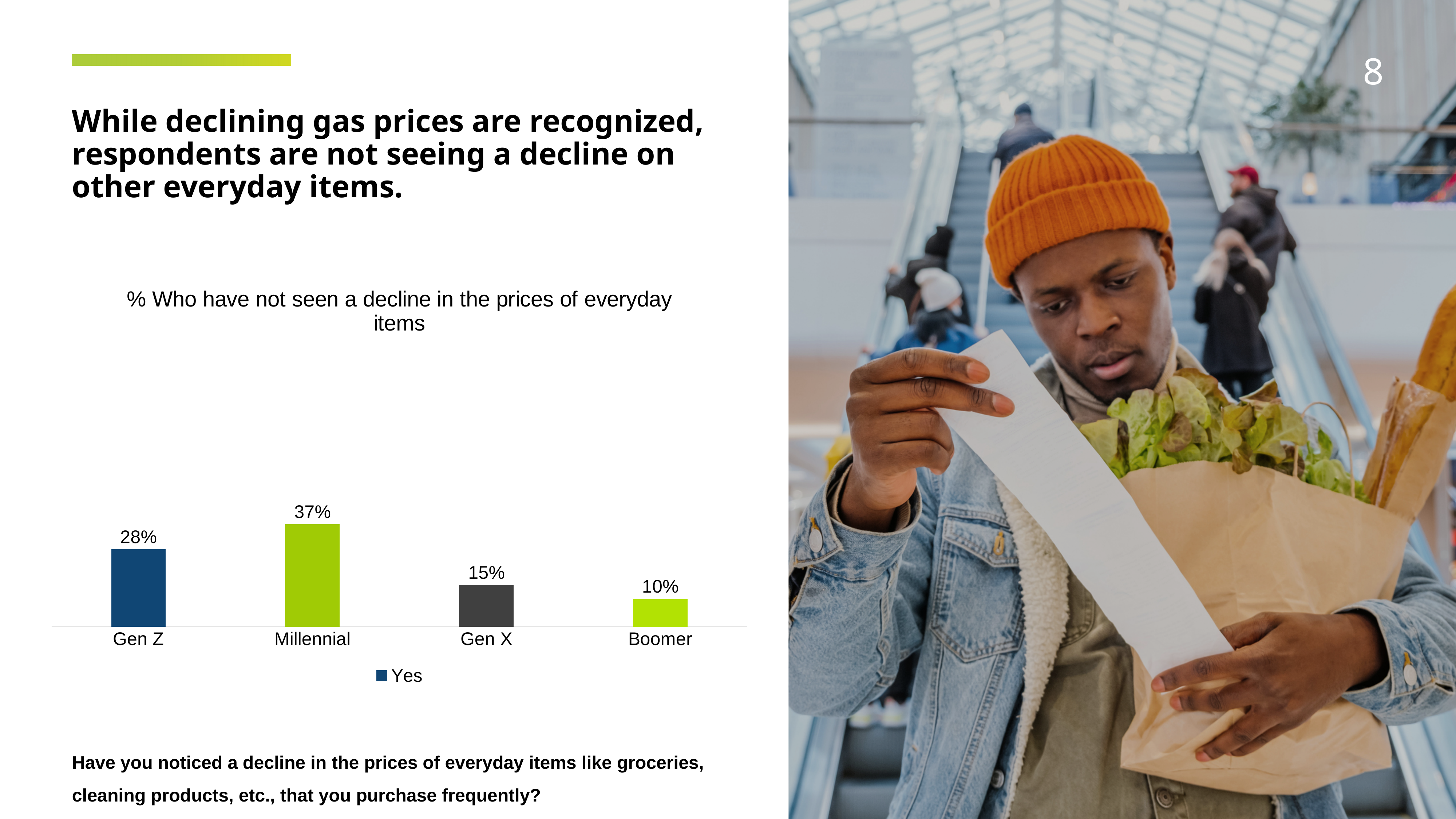
What is the difference between the values for Gen X and Boomer? 5% What is the title of the chart? % Who have not seen a decline in the prices of everyday items What is the value for Boomer? 10% Which is larger, the value for Gen Z or the value for Gen X? Gen Z What is the value for Millennial? 37% Which category has the highest value? Millennial What is the value for Gen Z? 28% What is the value for Gen X? 15% Which category has the lowest value? Boomer What is the difference between the values for Millennial and Gen Z? 9% What kind of chart is shown on the slide? Bar chart How many categories are shown in the chart? 4